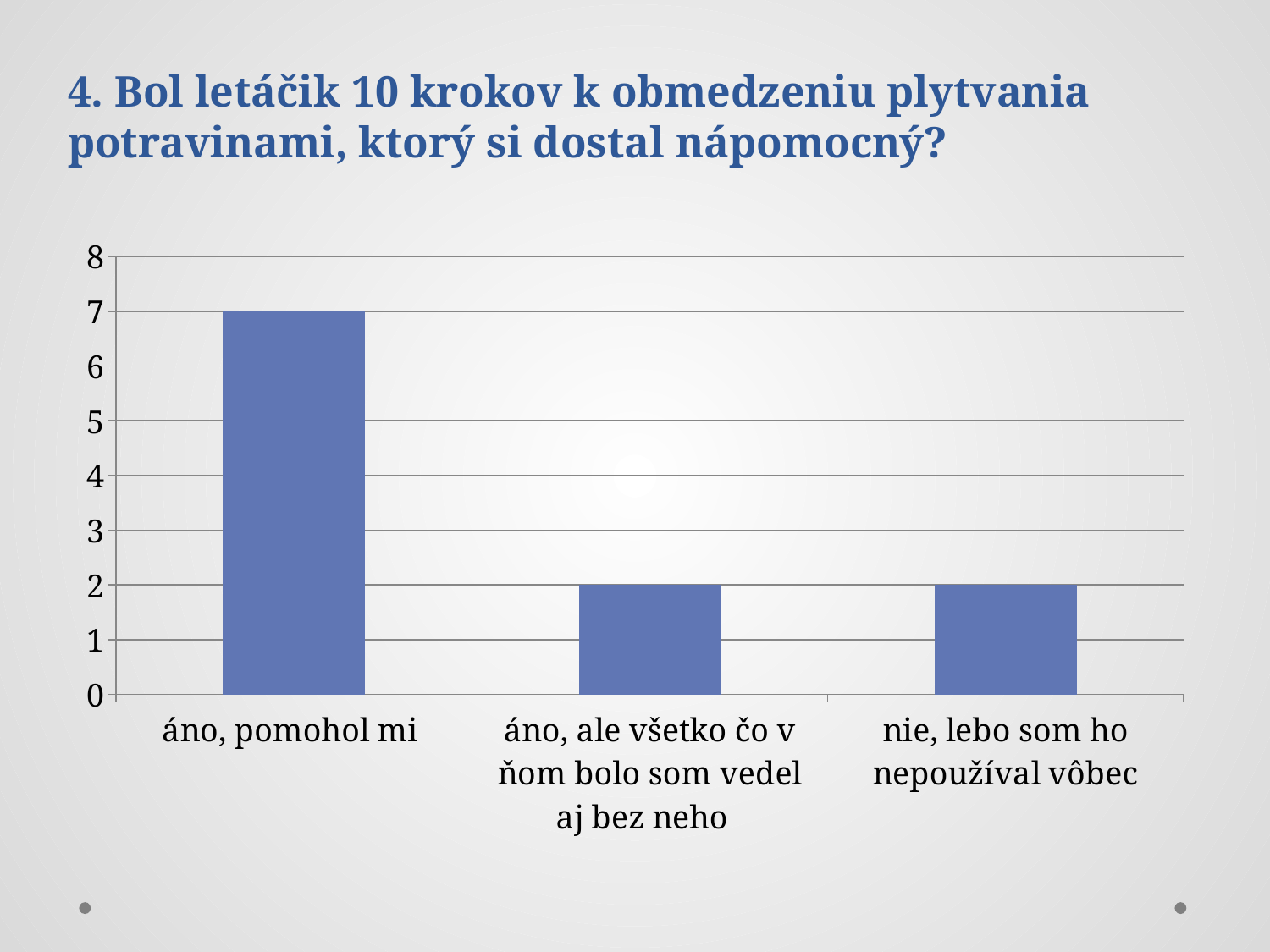
What kind of chart is shown on the slide? bar chart What is the value for "nie, lebo som ho nepoužíval vôbec"? 2 How many categories are shown on the x axis? 3 Is the value for "nie, lebo som ho nepoužíval vôbec" greater or less than 4? less What is the highest value shown on the y axis? 8 Which is larger, the value for "áno, pomohol mi" or the value for "áno, ale všetko čo v ňom bolo som vedel aj bez neho"? áno, pomohol mi What is the value for "áno, ale všetko čo v ňom bolo som vedel aj bez neho"? 2 Is the value for "áno, pomohol mi" greater or less than 5? greater What is the difference between the values for "áno, pomohol mi" and "nie, lebo som ho nepoužíval vôbec"? 5 What is the value for "áno, pomohol mi"? 7 Which category has the highest value? áno, pomohol mi What is the title of the slide above the chart? 4. Bol letáčik 10 krokov k obmedzeniu plytvania potravinami, ktorý si dostal nápomocný?